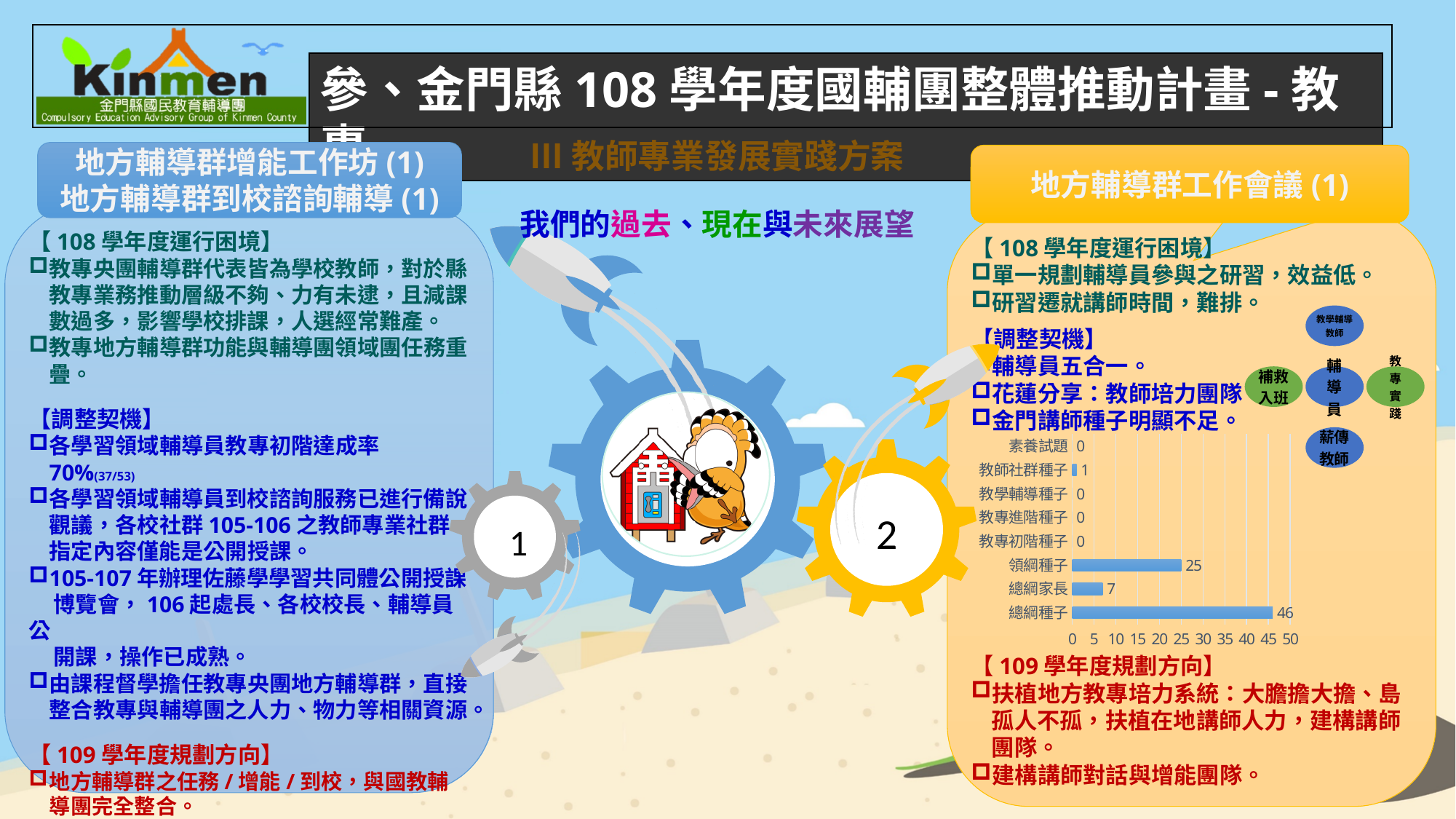
Which category has the highest value in the bar chart? 總綱種子 What is the difference between the values for 總綱種子 and 領綱種子? 21 What is the value for 總綱種子 in the bar chart? 46 What is the difference between the values for 領綱種子 and 總綱家長? 18 How many categories are shown in the bar chart? 8 What is the value for 素養試題 in the bar chart? 0 What kind of chart is shown on the slide? bar chart What is the value for 總綱家長 in the bar chart? 7 Is the value for 總綱種子 greater or less than 40? greater Which is larger, the value for 總綱家長 or the value for 教師社群種子? 總綱家長 What is the value for 領綱種子 in the bar chart? 25 What is the value for 教師社群種子 in the bar chart? 1